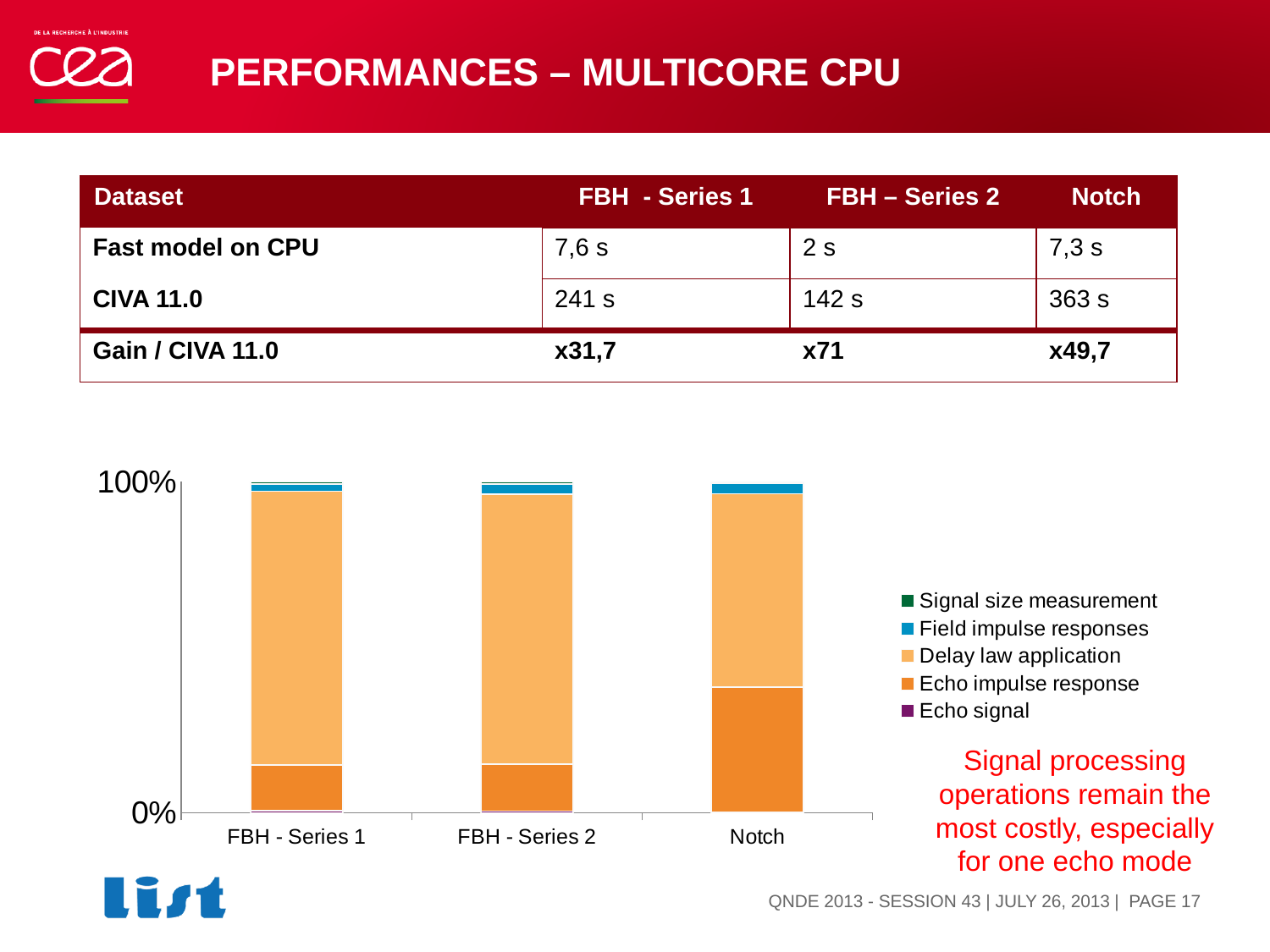
What kind of chart is shown on the slide? Stacked bar chart Is the Echo impulse response segment larger for Notch or for FBH - Series 2? Notch What is the label of the third category on the x axis? Notch How many series does the chart legend list? 5 Which series occupies the largest share of each bar in the chart? Delay law application Is the Delay law application segment larger for FBH - Series 1 or for Notch? FBH - Series 1 What is the label of the top tick on the y axis of the chart? 100% Which legend entry is shown in dark green? Signal size measurement Which category has the smallest Delay law application segment? Notch Which category has the largest Echo impulse response segment? Notch How many categories are shown on the x axis of the chart? 3